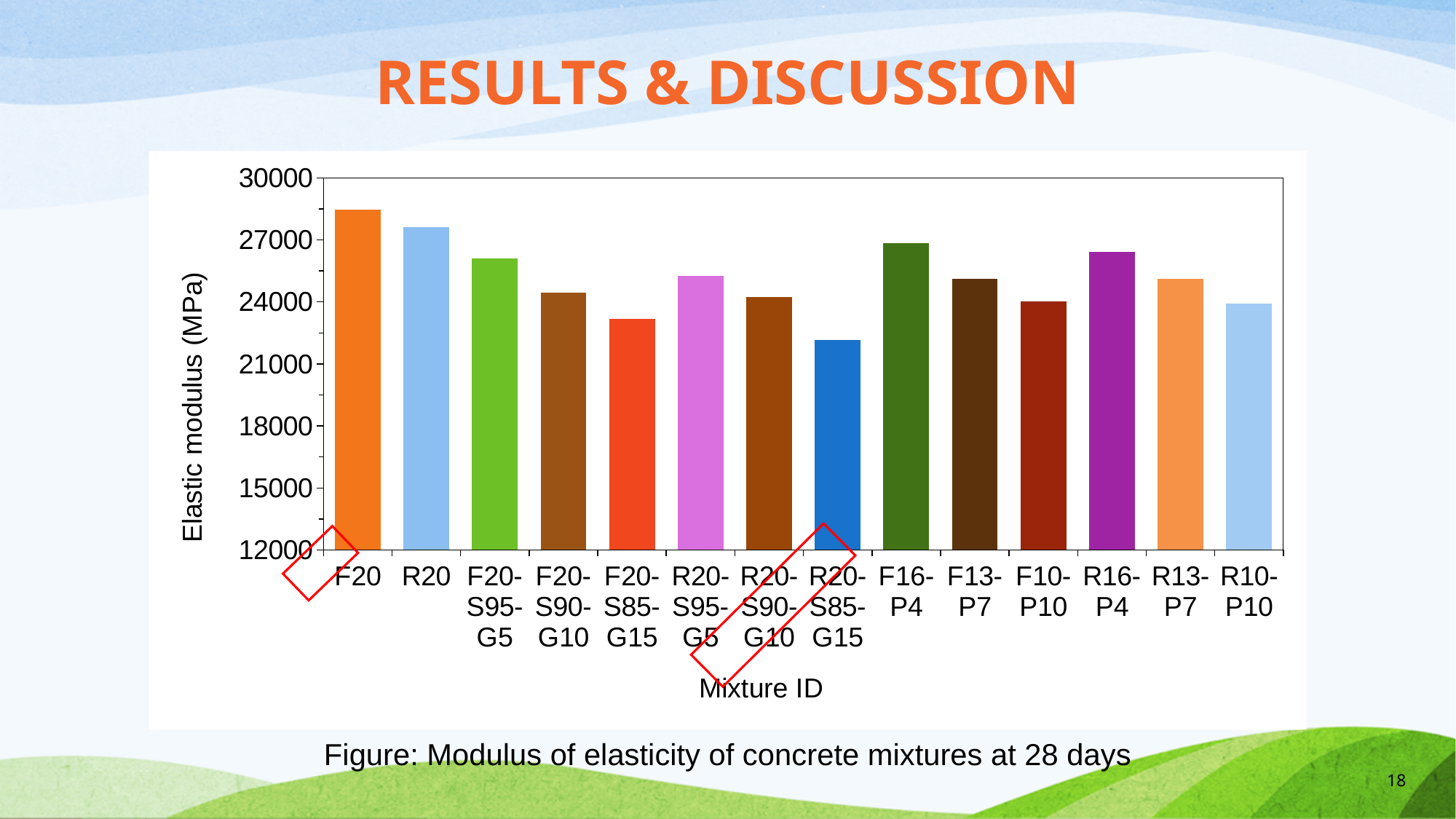
Is the elastic modulus for R16-P4 greater or less than 24000? greater Is the elastic modulus for F20 greater or less than 27000? greater What is the label of the y axis? Elastic modulus (MPa) Which mixture has the lowest elastic modulus? R20-S85-G15 How many mixture IDs are plotted on the x axis? 14 Which has a higher elastic modulus, F16-P4 or F10-P10? F16-P4 Is the elastic modulus for R20-S85-G15 greater or less than 24000? less What kind of chart is shown on the slide? Bar chart Do the values rise or fall across the bars F20, F20-S95-G5, F20-S90-G10 and F20-S85-G15? fall Which mixture has the highest elastic modulus? F20 Which has a higher elastic modulus, F20 or R20? F20